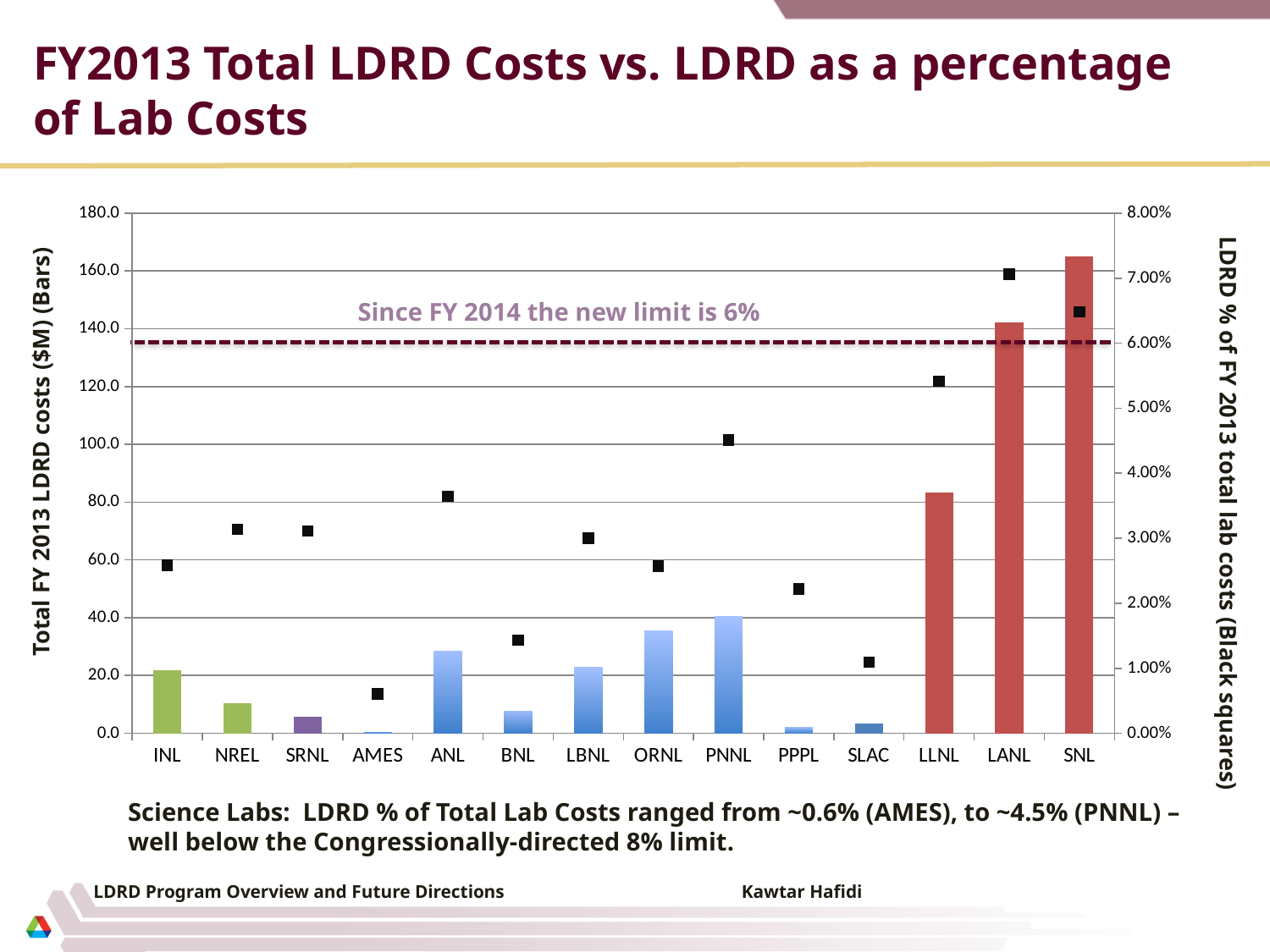
Which lab has the lowest black square (LDRD % of total lab costs)? AMES Which lab has the larger Total FY 2013 LDRD costs bar, ANL or BNL? ANL Which lab has the tallest bar for Total FY 2013 LDRD costs? SNL Which lab has the larger Total FY 2013 LDRD costs bar, LLNL or PNNL? LLNL What does the label above the dashed horizontal line say? Since FY 2014 the new limit is 6% Is the black square for LANL greater or less than 6.00%? greater Is the Total FY 2013 LDRD costs bar for LLNL greater or less than 100.0? less Which lab has the highest black square (LDRD % of total lab costs)? LANL How many labs are shown along the x axis of the chart? 14 Is the black square for PNNL greater or less than 4.00%? greater Which lab has the shortest bar for Total FY 2013 LDRD costs? AMES